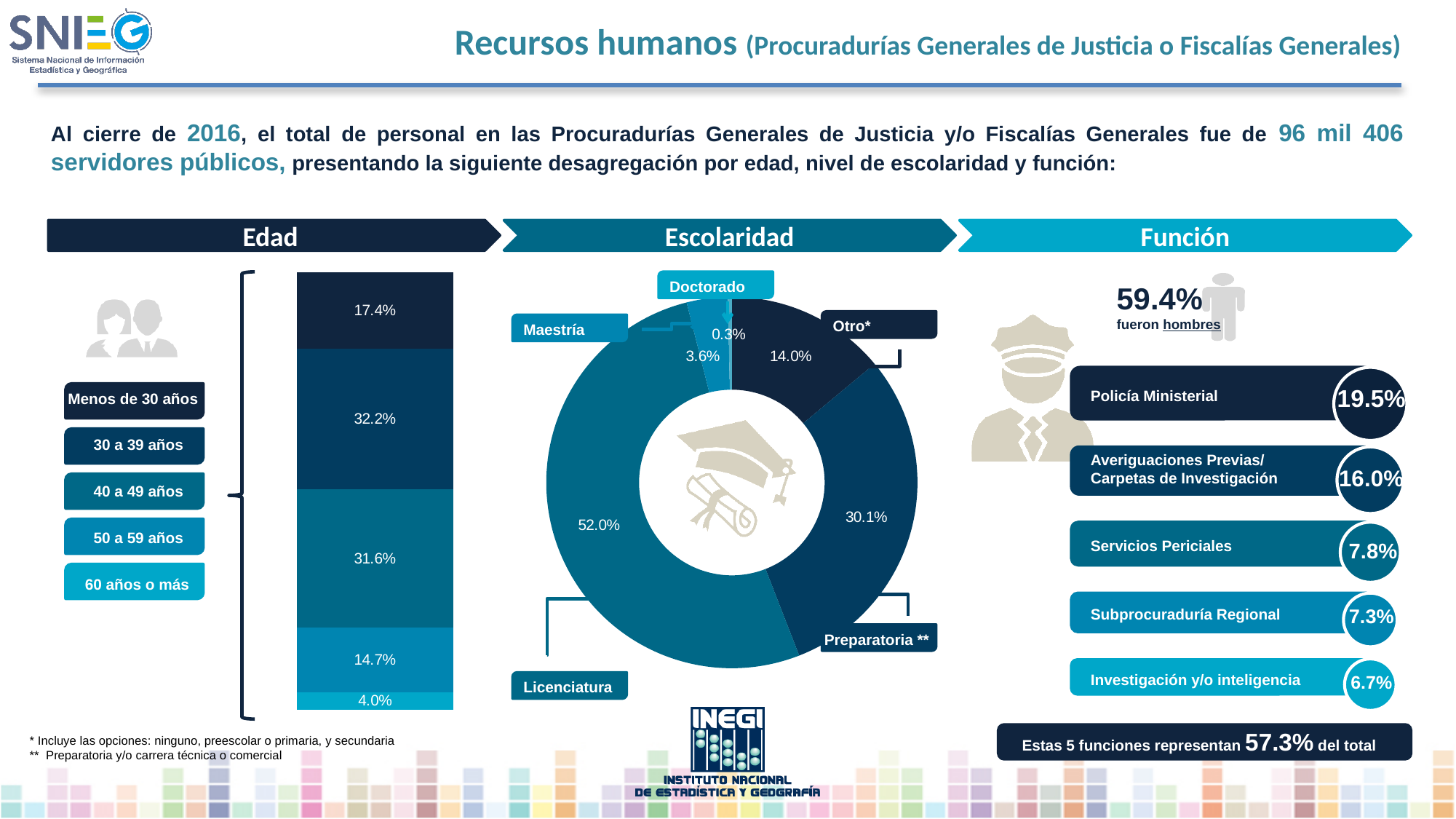
In the Edad chart, what percentage corresponds to the 30 a 39 años segment? 32.2% In the Edad chart, how many age groups are shown? 5 In the Edad chart, which age group has the largest share? 30 a 39 años In the Escolaridad chart, what percentage corresponds to Doctorado? 0.3% In the Escolaridad chart, what percentage corresponds to Licenciatura? 52.0% In the Escolaridad chart, which category has the largest share? Licenciatura What kind of chart is used in the Edad section? Stacked bar chart In the Escolaridad chart, which is larger, Preparatoria ** or Otro*? Preparatoria ** In the Edad chart, what is the difference between the 30 a 39 años and 40 a 49 años segments? 0.6% In the Edad chart, which age group has the smallest share? 60 años o más What kind of chart is used in the Escolaridad section? Donut chart In the Edad chart, what percentage corresponds to the 60 años o más segment? 4.0%